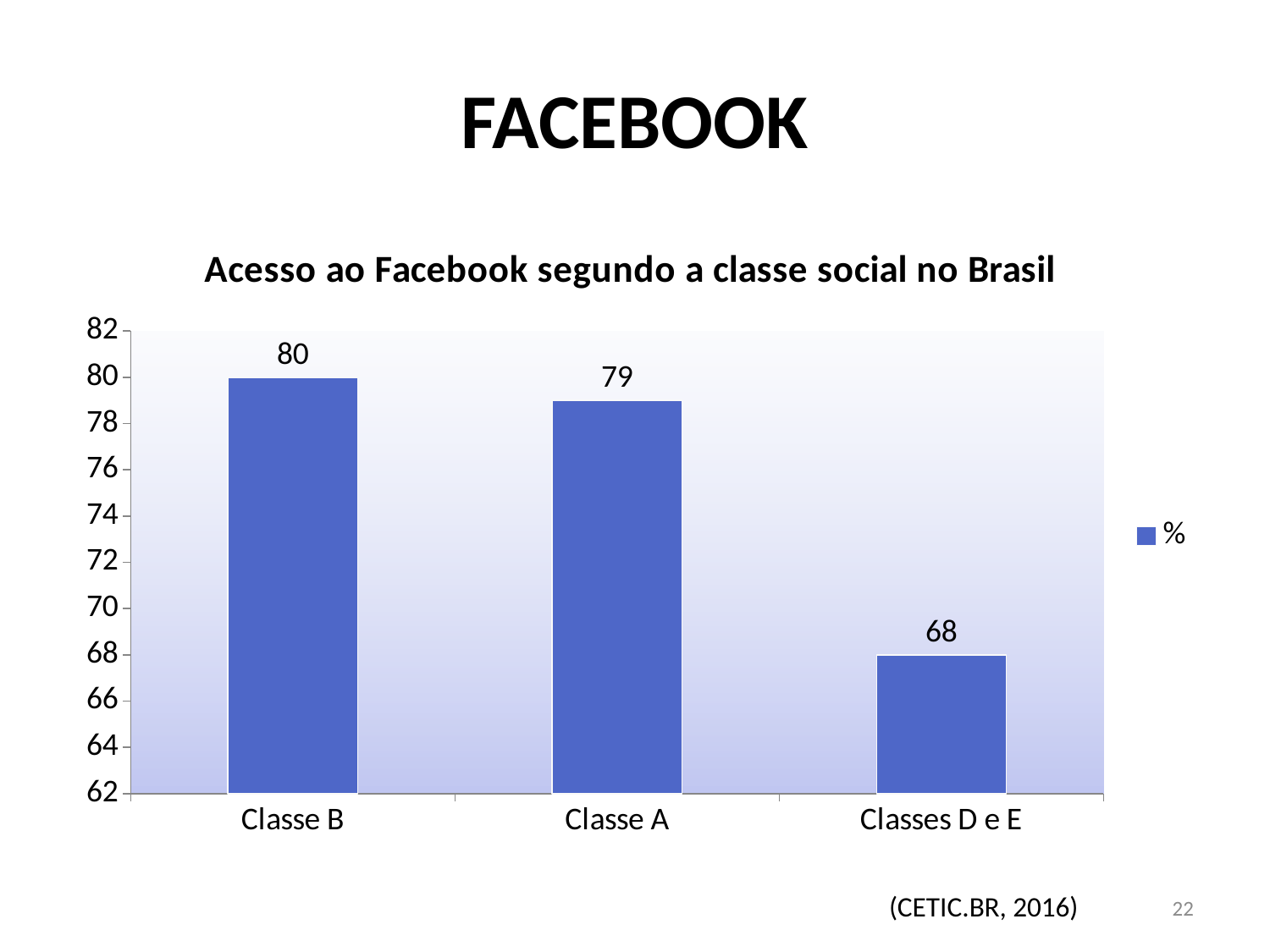
What is the value for Classe A? 79 What is the value for Classe B? 80 What is the title of the chart? Acesso ao Facebook segundo a classe social no Brasil What is the difference between the values for Classe A and Classes D e E? 11 How many categories are shown on the x axis? 3 Which is larger, the value for Classe A or the value for Classes D e E? Classe A What is the difference between the values for Classe B and Classes D e E? 12 Is the value for Classes D e E greater or less than 70? less Which category has the highest value? Classe B What is the value for Classes D e E? 68 What kind of chart is shown on the slide? bar chart Which category has the lowest value? Classes D e E